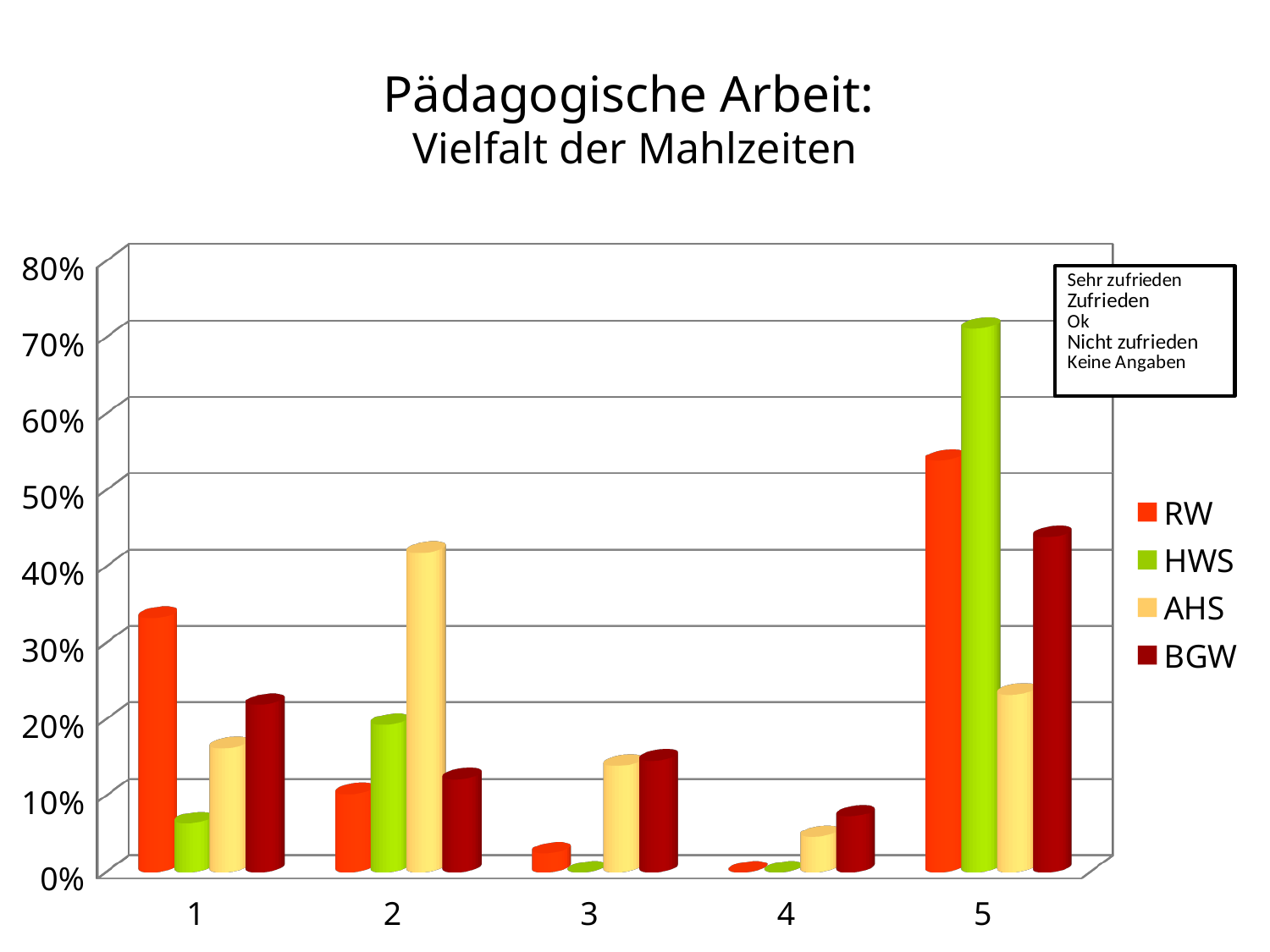
What kind of chart is shown on the slide? bar chart In which category does the AHS series reach its highest value? 2 In category 1, which is larger: RW or BGW? RW Is the value for RW in category 5 greater or less than 50%? greater In which category does the HWS series reach its highest value? 5 In category 5, which series has the highest value? HWS In category 2, which is larger: AHS or HWS? AHS How many series does the legend list? 4 Is the value for AHS in category 2 greater or less than 40%? greater Is the value for HWS in category 1 greater or less than 10%? less How many categories are shown on the x axis? 5 What is the title of the chart? Pädagogische Arbeit: Vielfalt der Mahlzeiten